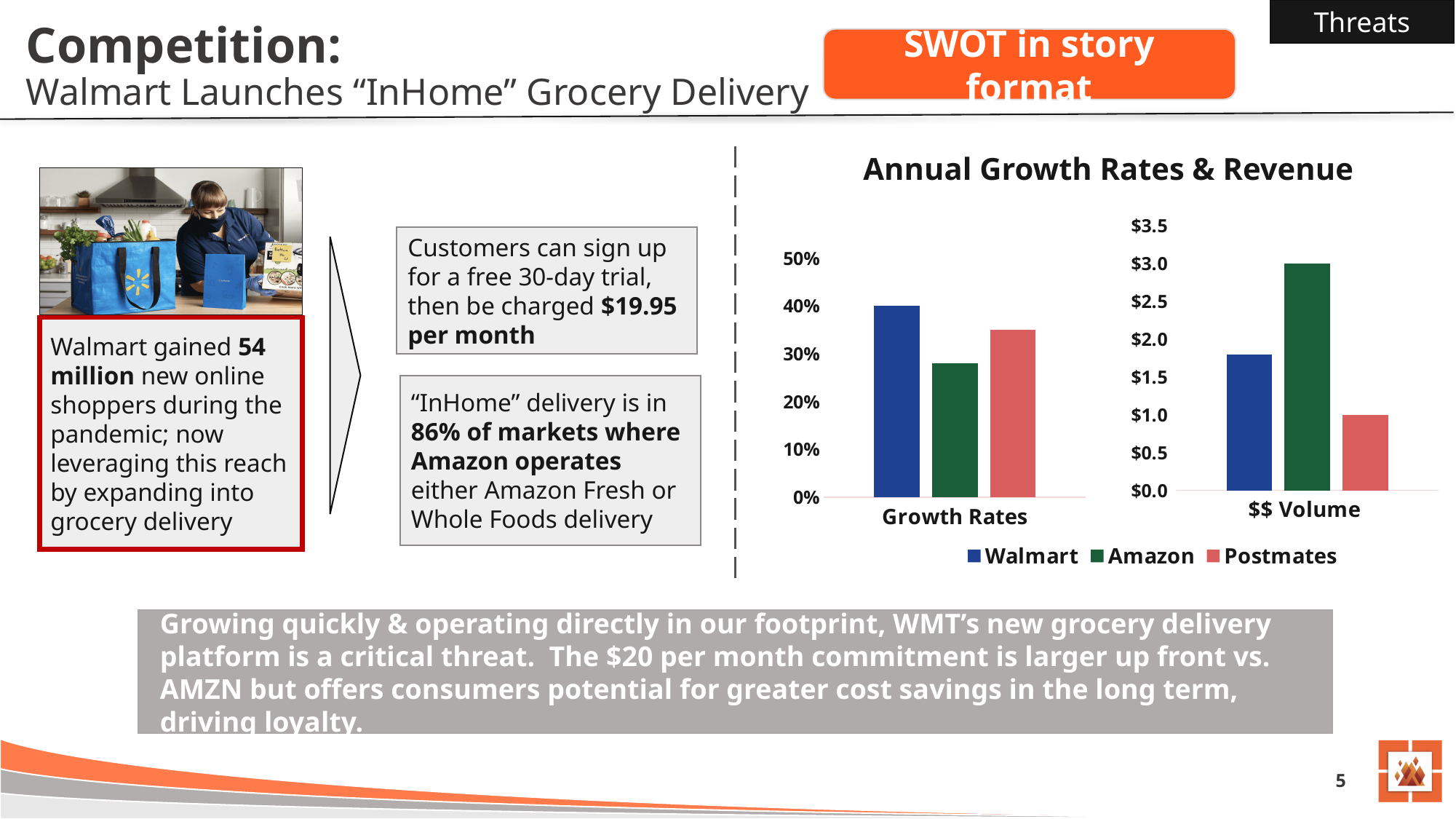
In the "Annual Growth Rates & Revenue" chart, what colour represents Amazon in the legend? green In the Growth Rates panel, which company has the highest growth rate? Walmart In the Growth Rates panel, which company has the lowest growth rate? Amazon What kind of chart is shown under the title "Annual Growth Rates & Revenue"? bar chart In the Growth Rates panel, which is larger, the value for Walmart or the value for Postmates? Walmart How many series does the legend of the "Annual Growth Rates & Revenue" chart list? 3 In the $$ Volume panel, which company has the highest value? Amazon In the Growth Rates panel, is the value for Postmates greater or less than 30%? greater In the Growth Rates panel, is the value for Amazon greater or less than 30%? less What is the title of the chart on the right side of the slide? Annual Growth Rates & Revenue In the $$ Volume panel, which company has the lowest value? Postmates In the $$ Volume panel, is the value for Walmart greater or less than $1.5? greater